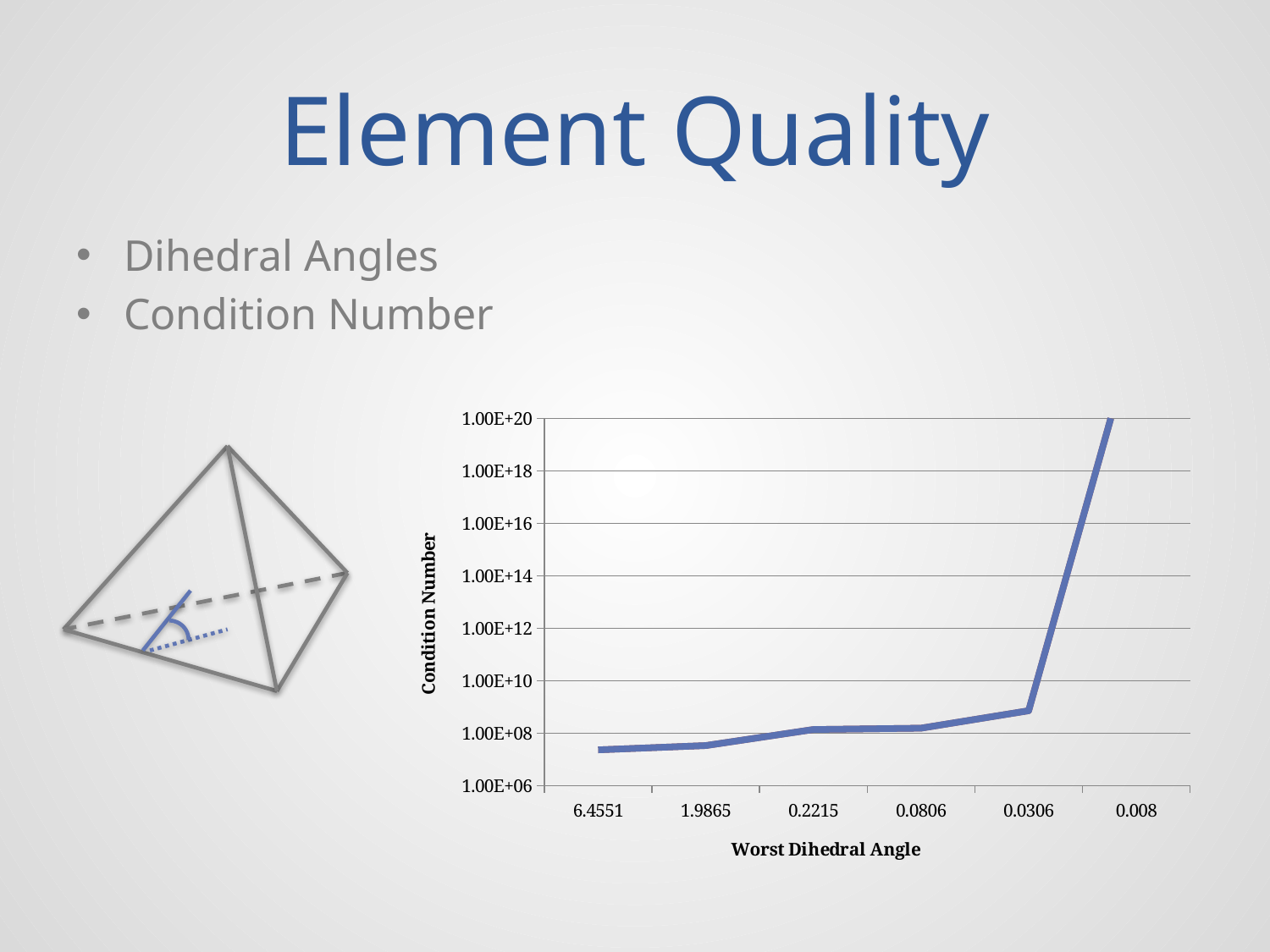
What kind of chart is shown on the slide? line chart What is the highest value shown on the y axis of the chart? 1.00E+20 Is the condition number at a worst dihedral angle of 0.0306 greater or less than 1.00E+10? less What is the title of the y axis of the chart? Condition Number How many category labels are shown on the x axis of the chart? 6 Is the condition number at a worst dihedral angle of 6.4551 greater or less than 1.00E+08? less Which has the larger condition number, a worst dihedral angle of 6.4551 or 0.0306? 0.0306 Is the condition number at a worst dihedral angle of 6.4551 greater or less than 1.00E+06? greater Which labeled worst dihedral angle has the lowest condition number? 6.4551 Does the condition number rise or fall moving from left to right along the x axis? rise What is the title of the x axis of the chart? Worst Dihedral Angle